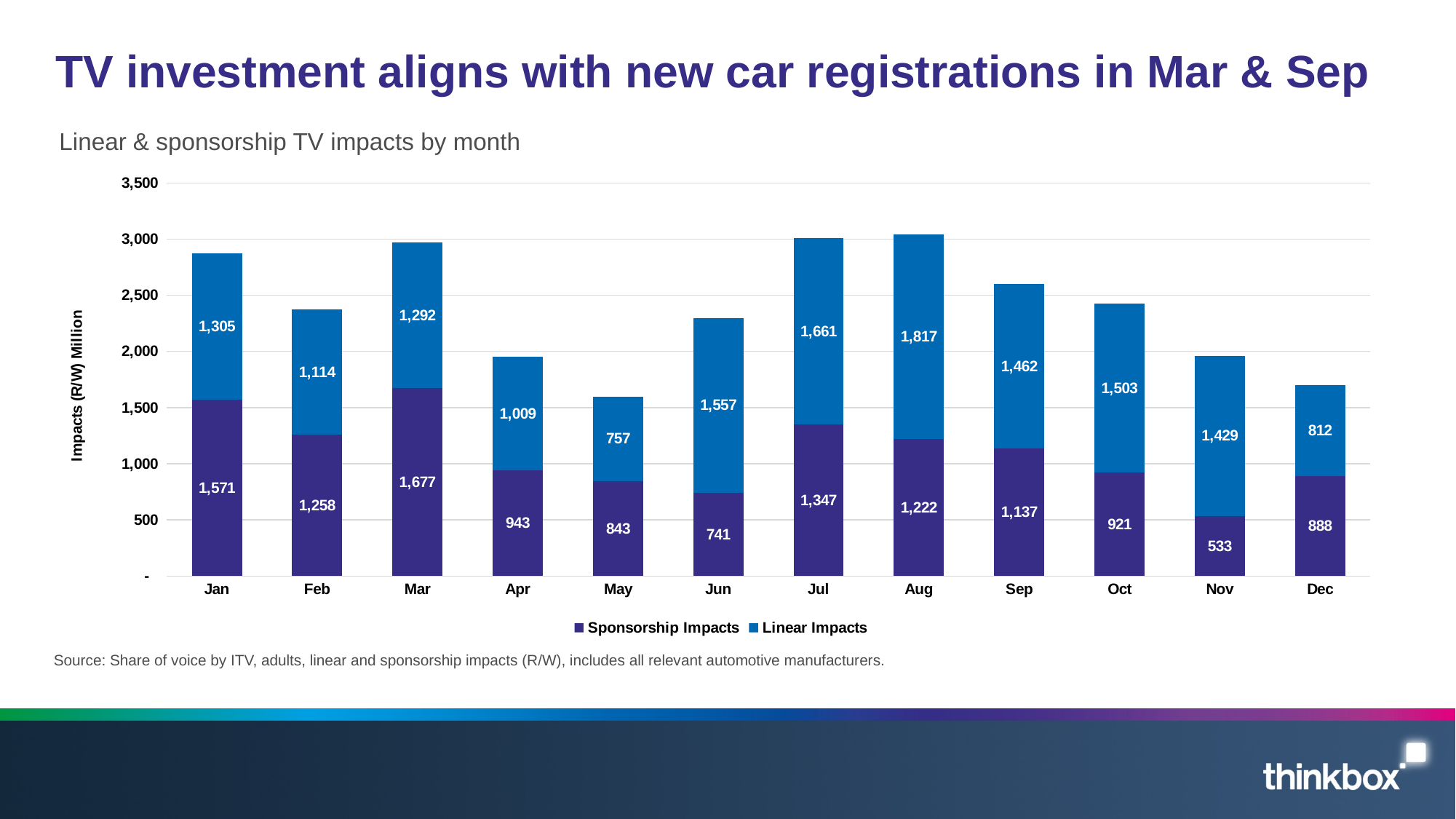
Which month has the highest Linear Impacts value? Aug What is the Sponsorship Impacts value for Mar? 1,677 How many months are shown on the x axis? 12 Which is larger, the Linear Impacts value for Jun or for Sep? Jun What is the difference between the Sponsorship Impacts values for Jan and Feb? 313 What is the total of the stacked bar for Dec? 1,700 What is the Sponsorship Impacts value for Nov? 533 How many series does the legend list? 2 What is the Linear Impacts value for Aug? 1,817 Which month has the lowest Linear Impacts value? May What type of chart is shown on the slide? Stacked bar chart Which month has the lowest Sponsorship Impacts value? Nov